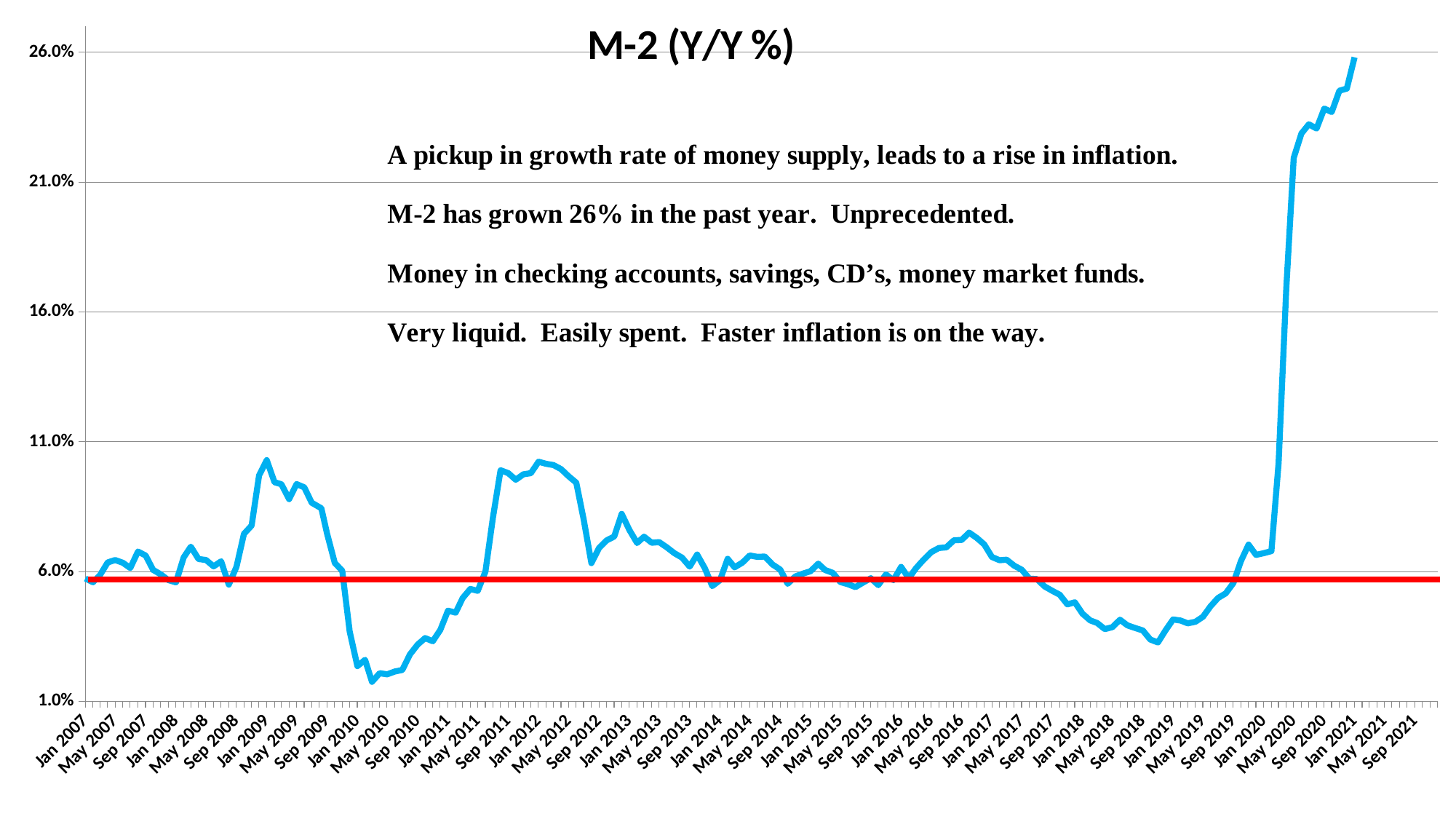
What colour is the plotted M-2 line? blue In which year does the line reach its highest value? 2021 Is the value for Jan 2012 greater or less than 11.0%? less What kind of chart is shown on the slide? line chart Is the value for Jan 2021 greater or less than 21.0%? greater What is the title of the chart? M-2 (Y/Y %) Is the value for May 2010 greater or less than 6.0%? less In which year does the line reach its lowest value? 2010 Between Jan 2020 and Jan 2021, does the line rise or fall? rise